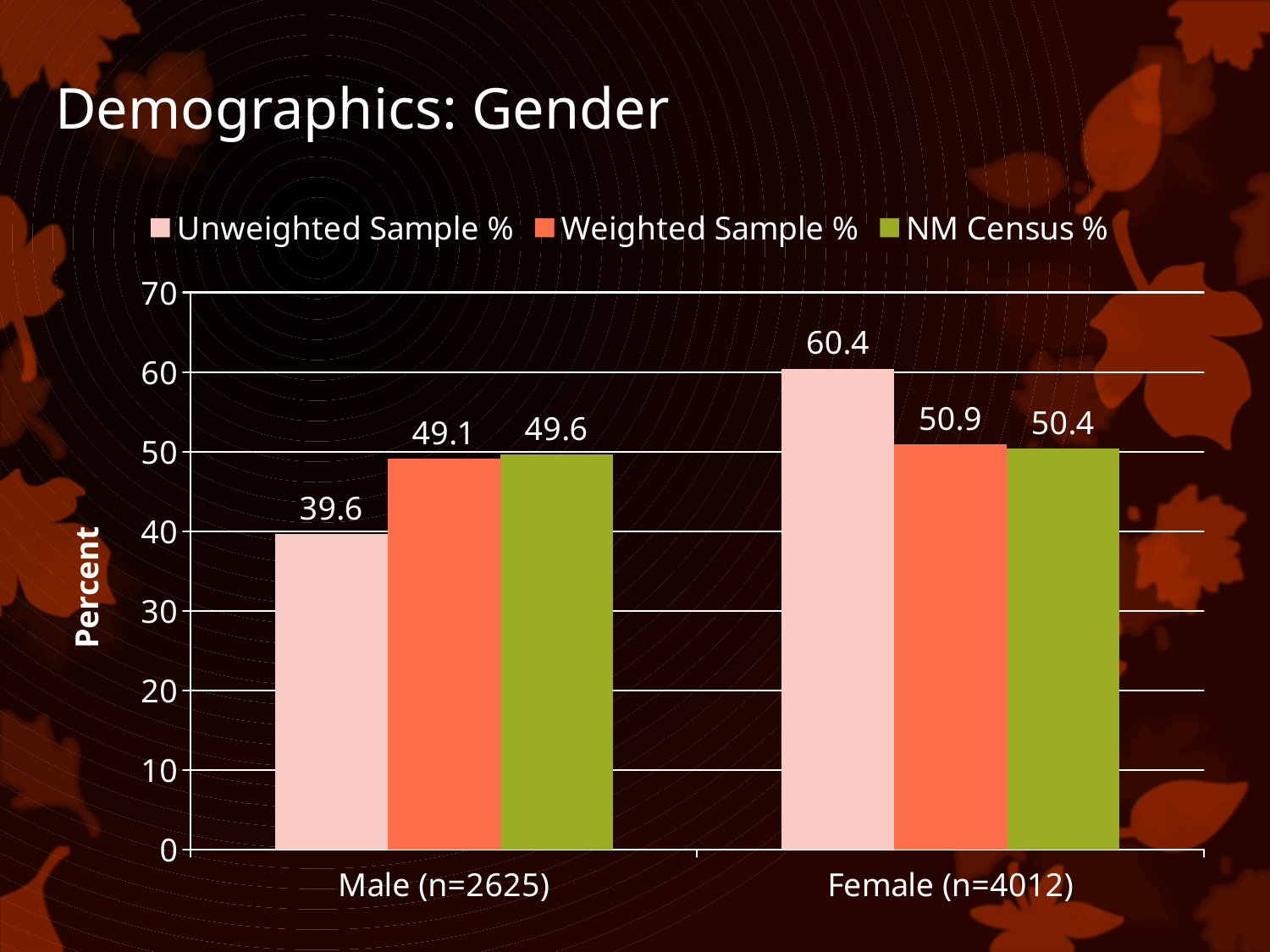
What is the Weighted Sample % value for Male (n=2625)? 49.1 What is the difference between the Unweighted Sample % values for Female (n=4012) and Male (n=2625)? 20.8 What is the Unweighted Sample % value for Male (n=2625)? 39.6 What kind of chart is shown on the slide? Bar chart What is the label of the y axis? Percent How many series does the legend list? 3 What is the NM Census % value for Female (n=4012)? 50.4 Is the Weighted Sample % value for Female (n=4012) larger than the Weighted Sample % value for Male (n=2625)? Yes Is the Unweighted Sample % value for Female (n=4012) greater or less than 60? greater Which category has the highest Unweighted Sample % value? Female (n=4012) Which series has the lowest value for Male (n=2625)? Unweighted Sample % How many categories are shown on the x axis? 2